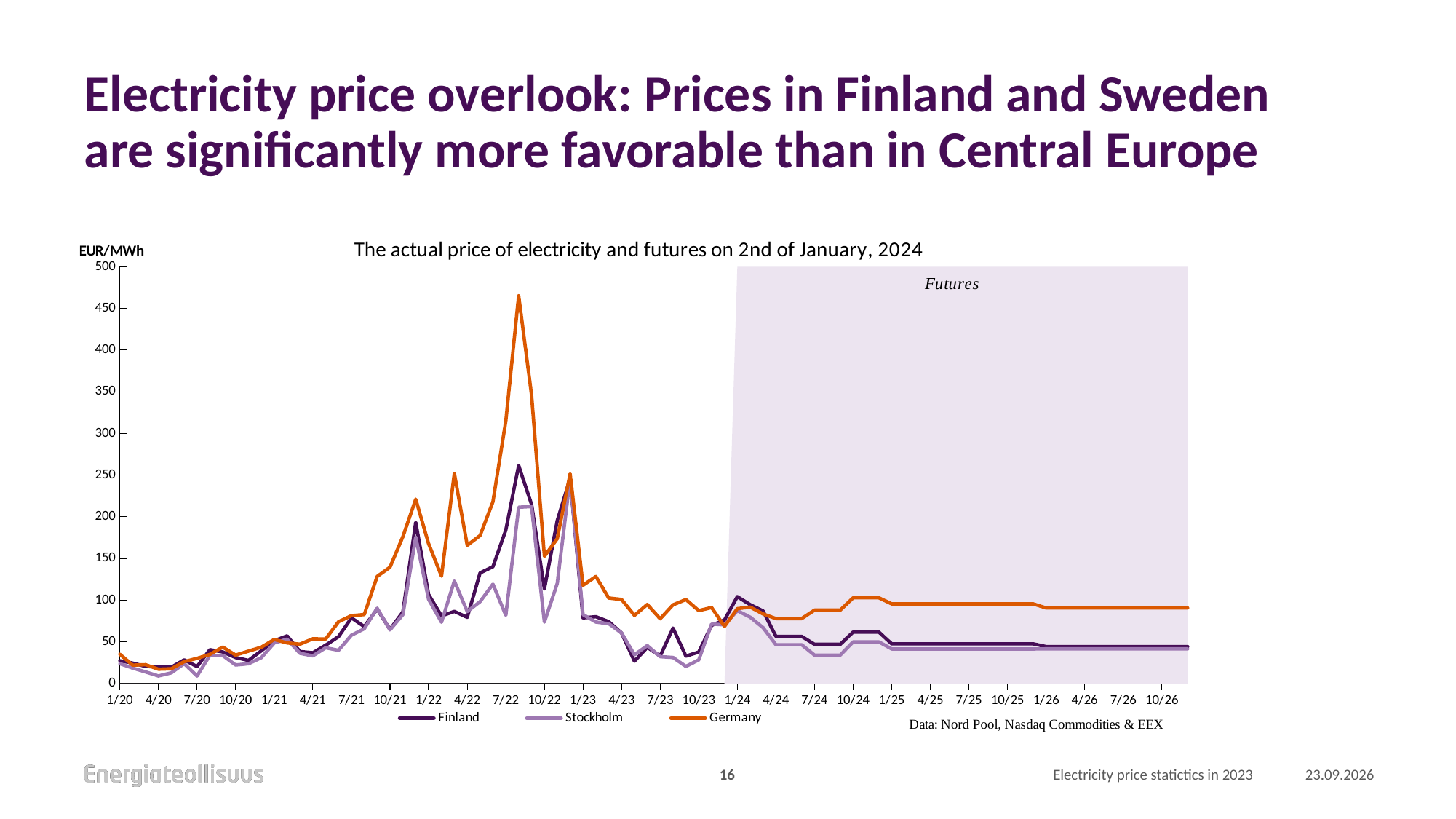
Which series reaches the highest peak on the chart? Germany Is the value for Stockholm at 1/20 greater or less than 50? less Is the value for Finland at 10/26 greater or less than 100? less Is the peak value for Germany around 7/22–10/22 greater or less than 400? greater What unit is shown on the y axis of the chart? EUR/MWh In the futures region, which series is higher: Germany or Stockholm? Germany How many series does the chart's legend list? 3 Which series has the lowest values in the futures region from 1/25 onward? Stockholm Which series are listed in the chart's legend? Finland, Stockholm, Germany What kind of chart is shown on the slide? line chart